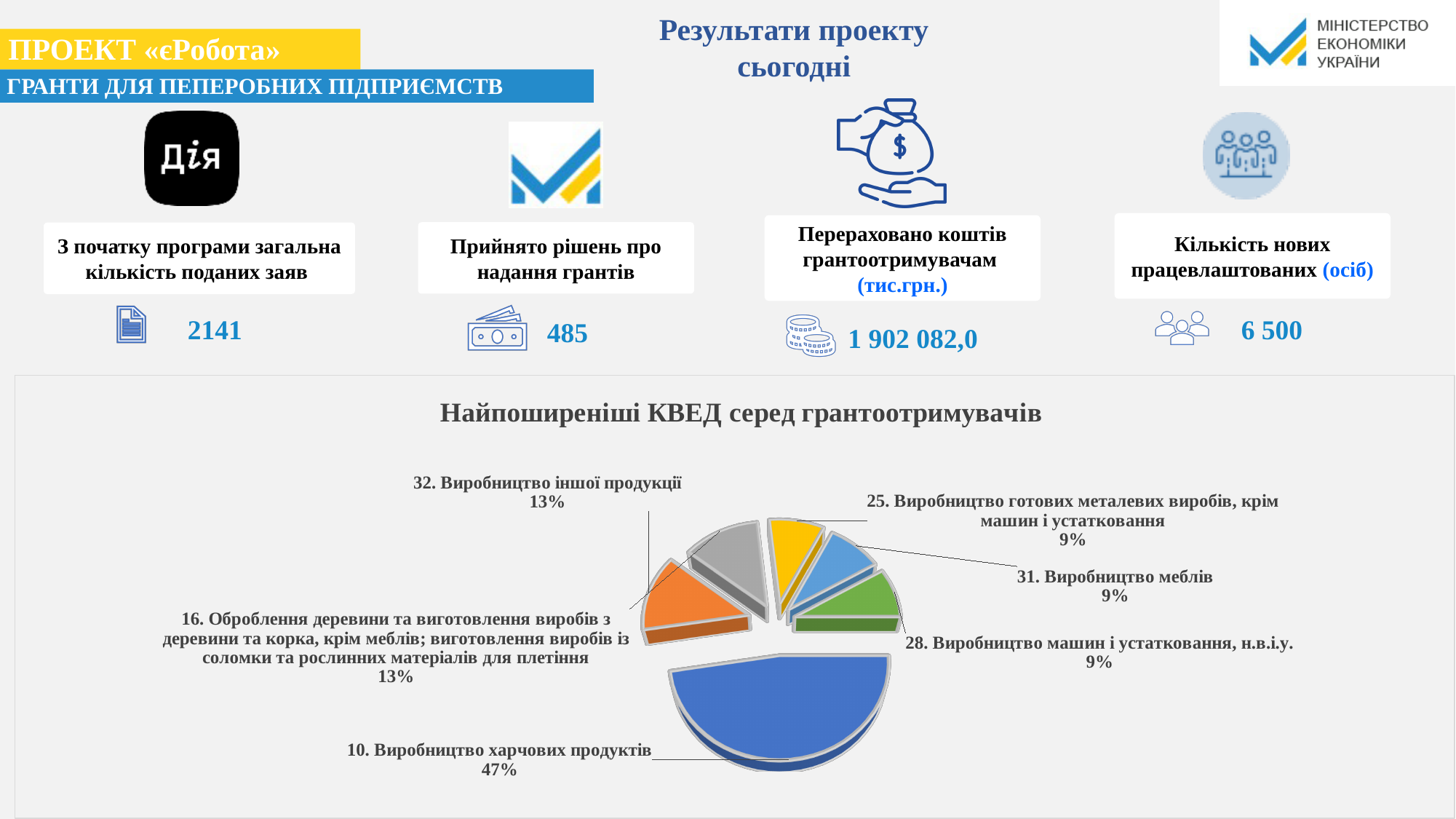
What colour is the slice for "10. Виробництво харчових продуктів"? blue What is the difference between the share of "32. Виробництво іншої продукції" and "31. Виробництво меблів"? 4% What is the value shown for "32. Виробництво іншої продукції"? 13% Which category has the largest slice of the pie? 10. Виробництво харчових продуктів What kind of chart is shown under the title "Найпоширеніші КВЕД серед грантоотримувачів"? pie chart What is the difference between the share of "10. Виробництво харчових продуктів" and "32. Виробництво іншої продукції"? 34% What share of the pie does "10. Виробництво харчових продуктів" have? 47% What is the value shown for "31. Виробництво меблів"? 9% Which is larger: the share of "16. Оброблення деревини..." or "25. Виробництво готових металевих виробів..."? 16. Оброблення деревини... How many slices does the pie chart have? 6 What is the chart's title? Найпоширеніші КВЕД серед грантоотримувачів What is the value shown for "28. Виробництво машин і устатковання, н.в.і.у."? 9%